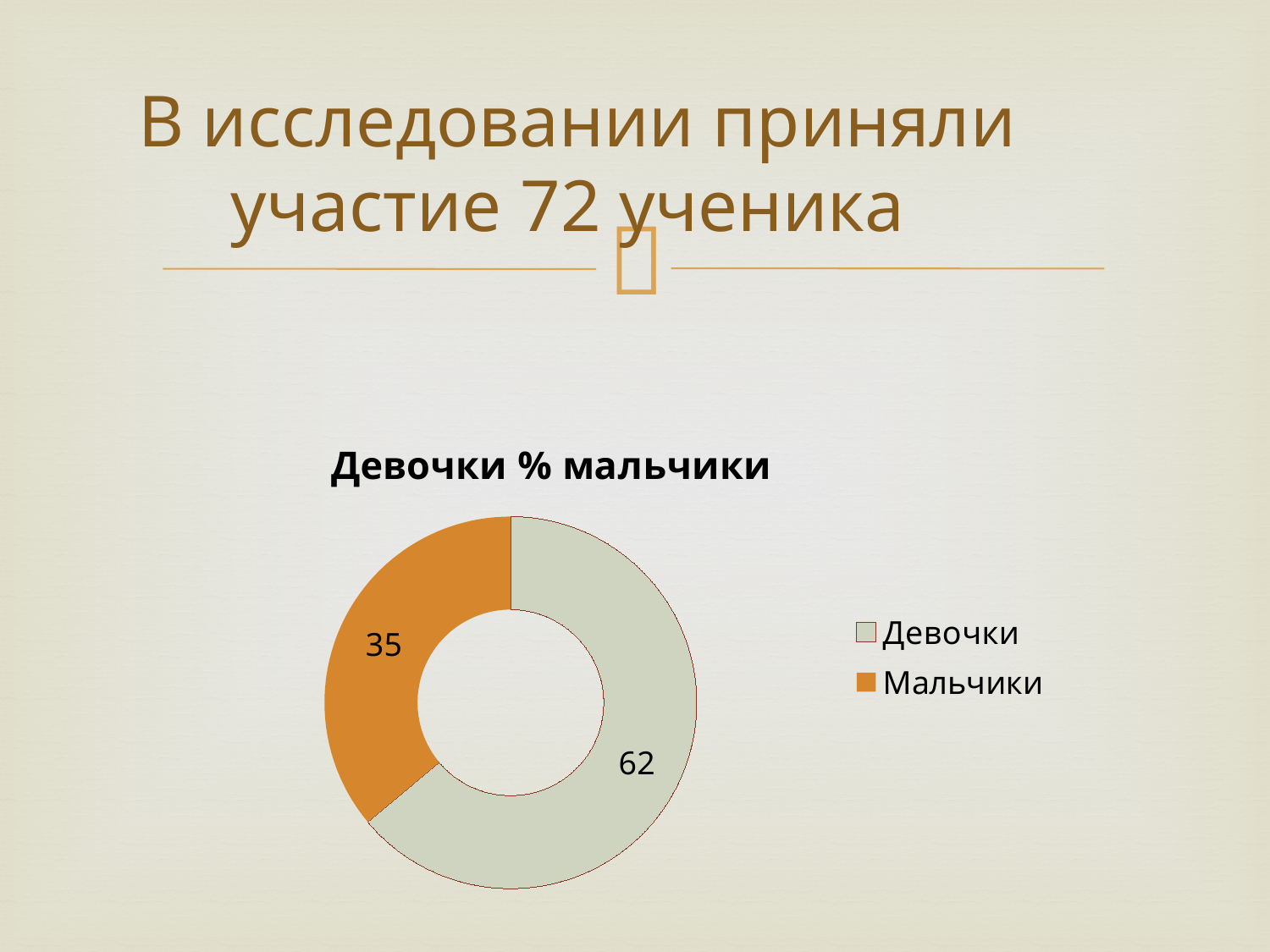
How many categories are shown in the chart? 2 What is the title of the chart? Девочки % мальчики What is the total of the two values shown in the chart? 97 What is the value shown for Девочки in the chart? 62 What is the value shown for Мальчики in the chart? 35 Which category has the smallest slice in the chart? Мальчики Which is larger, the value for Девочки or the value for Мальчики? Девочки Which category has the largest slice in the chart? Девочки Which category is shown in orange in the chart? Мальчики How many entries does the chart legend list? 2 What kind of chart is shown on the slide? Doughnut (pie) chart What is the difference between the values for Девочки and Мальчики? 27